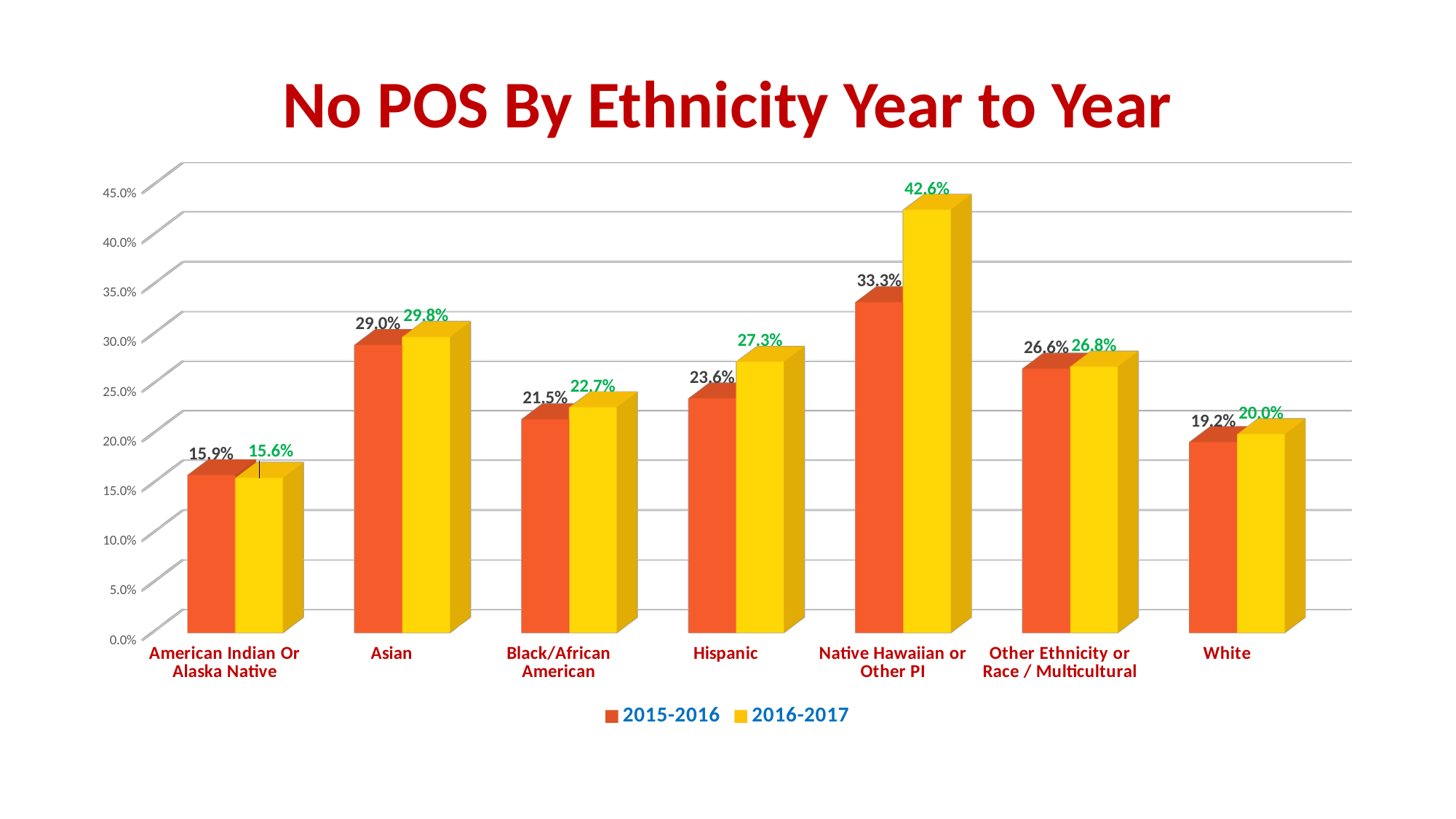
What is the 2016-2017 value for Native Hawaiian or Other PI? 42.6% What is the 2016-2017 value for White? 20.0% Which is larger, the 2015-2016 value for Asian or the 2015-2016 value for Other Ethnicity or Race / Multicultural? Asian How many series does the legend list? 2 Which is larger for American Indian Or Alaska Native, the 2015-2016 value or the 2016-2017 value? 2015-2016 How many ethnicity categories are shown on the chart? 7 What kind of chart is shown on the slide? Bar chart Which ethnicity has the lowest 2015-2016 value? American Indian Or Alaska Native What is the 2015-2016 value for Asian? 29.0% What is the difference between the 2016-2017 and 2015-2016 values for Hispanic? 3.7% What is the difference between the 2016-2017 and 2015-2016 values for Native Hawaiian or Other PI? 9.3% Which ethnicity has the highest 2016-2017 value? Native Hawaiian or Other PI